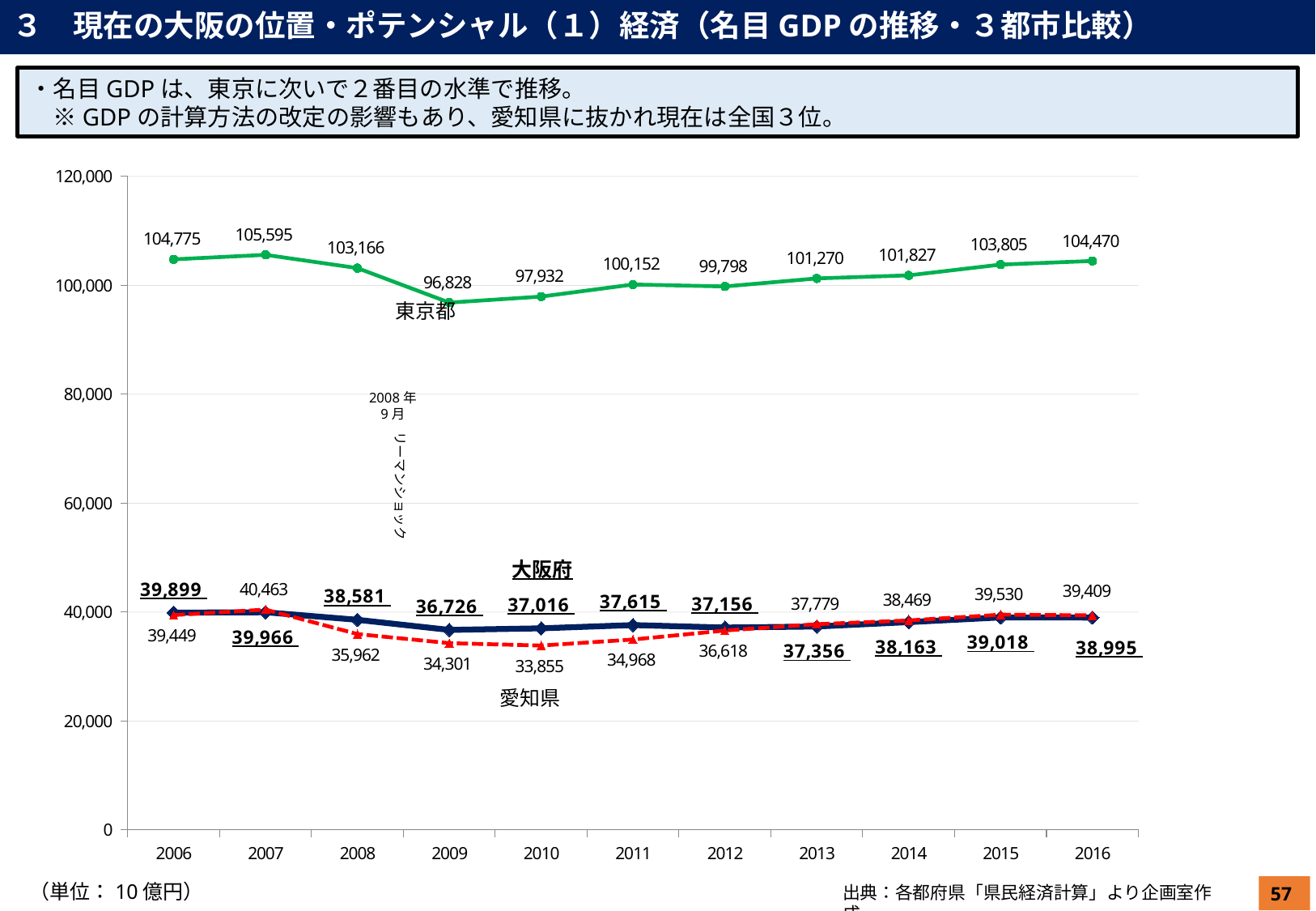
What type of chart is shown on the slide? line chart What is the value for 愛知県 in 2010? 33,855 In which year is the value for 東京都 lowest? 2009 What is the value for 大阪府 in 2009? 36,726 What is the difference between the 東京都 values in 2016 and 2006? 305 Does the value for 東京都 rise or fall from 2009 to 2016? rise Is the value for 東京都 in 2009 greater or less than 100,000? less Which is larger in 2016, the value for 大阪府 or the value for 愛知県? 愛知県 In which year is the value for 愛知県 highest? 2007 What is the difference between the 大阪府 and 愛知県 values in 2009? 2,425 What is the value for 東京都 in 2007? 105,595 How many years are shown on the x axis? 11